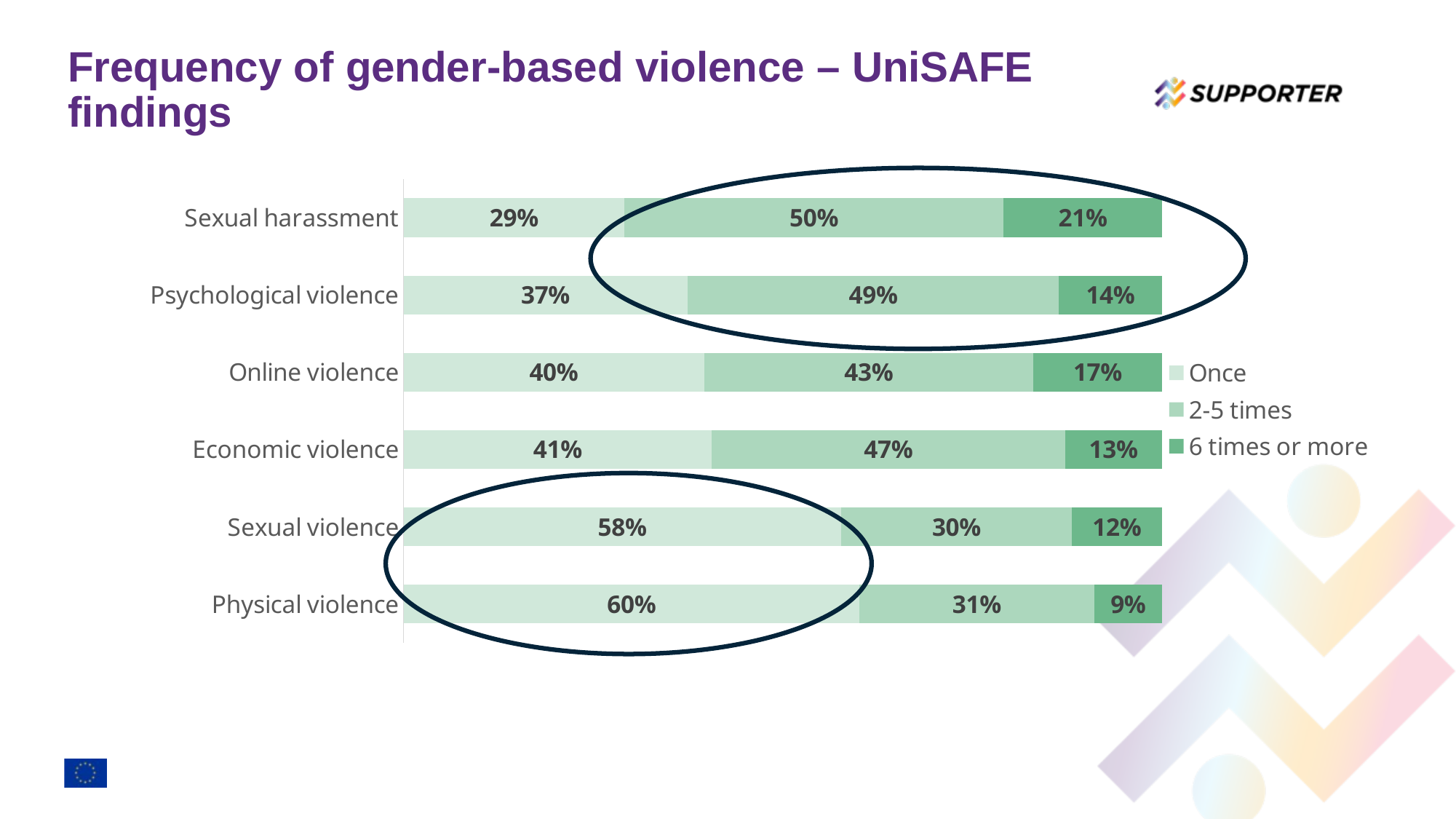
Which legend entry corresponds to the darkest green segments? 6 times or more How many series does the legend list? 3 What is the 'Once' value for physical violence? 60% What percentage of sexual harassment cases occurred 2-5 times? 50% Which is larger: the '2-5 times' value for online violence or for economic violence? Economic violence What kind of chart is shown on the slide? Stacked bar chart What is the total of the three segments for psychological violence? 100% What is the '6 times or more' value for economic violence? 13% How many categories are shown on the chart? 6 Which category has the lowest 'Once' share? Sexual harassment Which category has the highest '6 times or more' share? Sexual harassment What is the difference between the 'Once' values for physical violence and sexual harassment? 31%